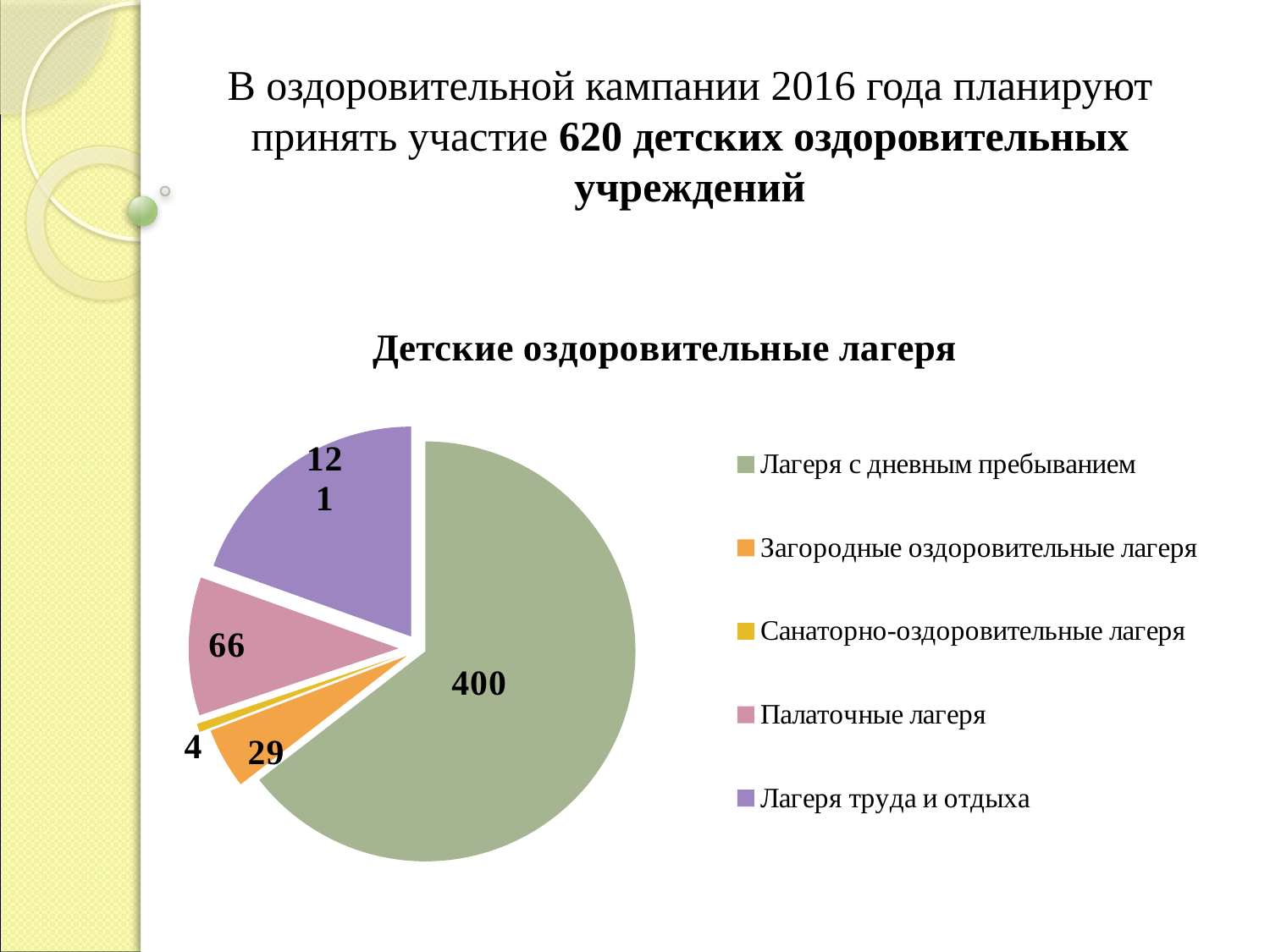
Which category has the smallest slice of the pie? Санаторно-оздоровительные лагеря Which is larger: the value for Палаточные лагеря or the value for Загородные оздоровительные лагеря? Палаточные лагеря How many categories does the legend of the pie chart list? 5 What is the value for Лагеря с дневным пребыванием? 400 Which category has the largest slice of the pie? Лагеря с дневным пребыванием What is the value for Палаточные лагеря? 66 What type of chart is shown on the slide? pie chart What is the title of the chart? Детские оздоровительные лагеря What is the value for Лагеря труда и отдыха? 121 What is the difference between the values for Лагеря труда и отдыха and Палаточные лагеря? 55 What is the value for Санаторно-оздоровительные лагеря? 4 What is the value for Загородные оздоровительные лагеря? 29